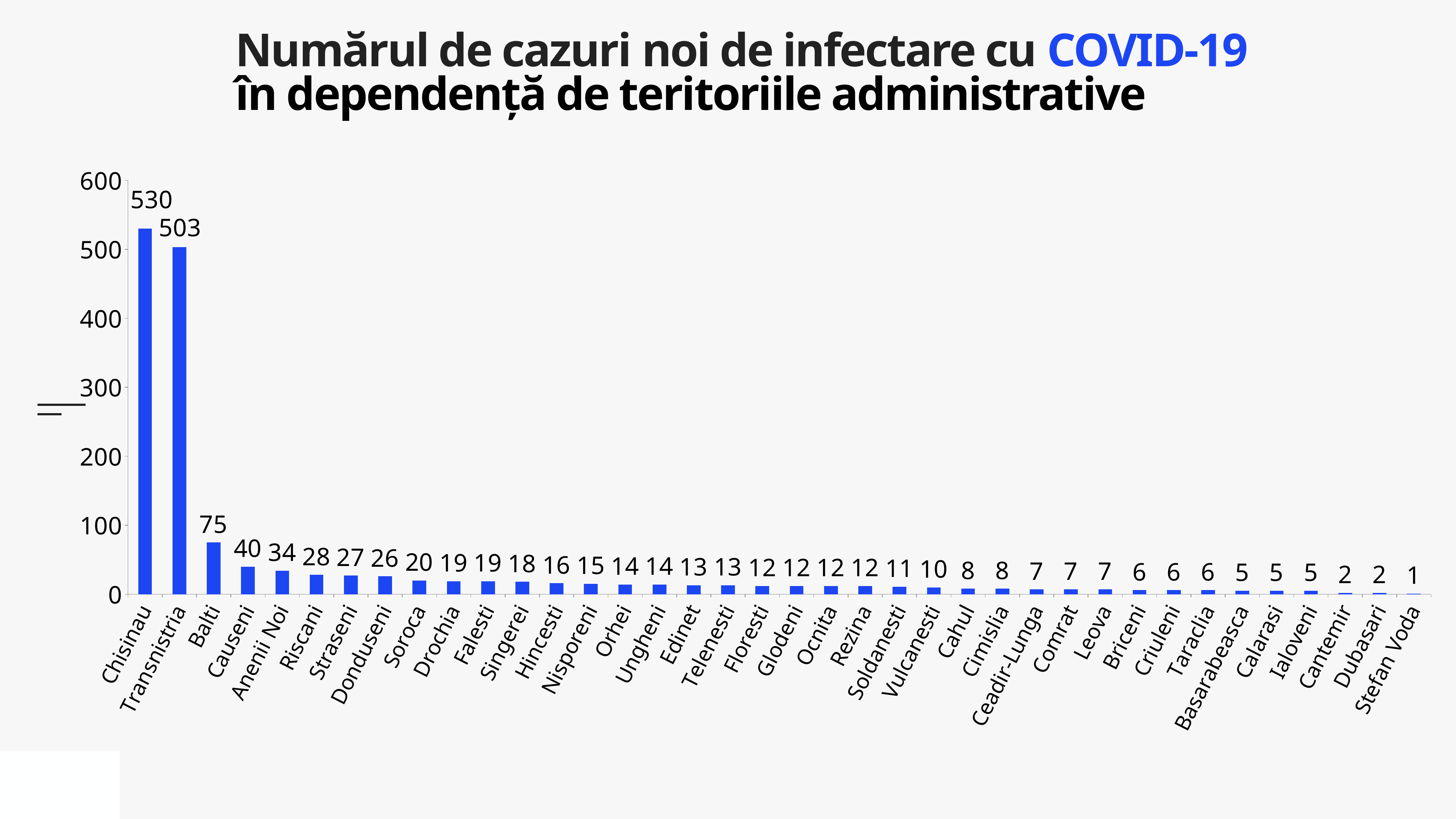
Which territory has the lowest number of new cases? Stefan Voda Which is larger, the value for Causeni or the value for Anenii Noi? Causeni What is the value for Soroca? 20 Is the value for Transnistria greater or less than 400? greater How many territories are shown on the chart? 38 Do the values rise or fall from left to right along the x axis? fall What is the value for Cahul? 8 What is the value for Chisinau? 530 What is the value for Balti? 75 What kind of chart is shown on the slide? bar chart What is the difference between the values for Chisinau and Transnistria? 27 Which territory has the highest number of new cases? Chisinau